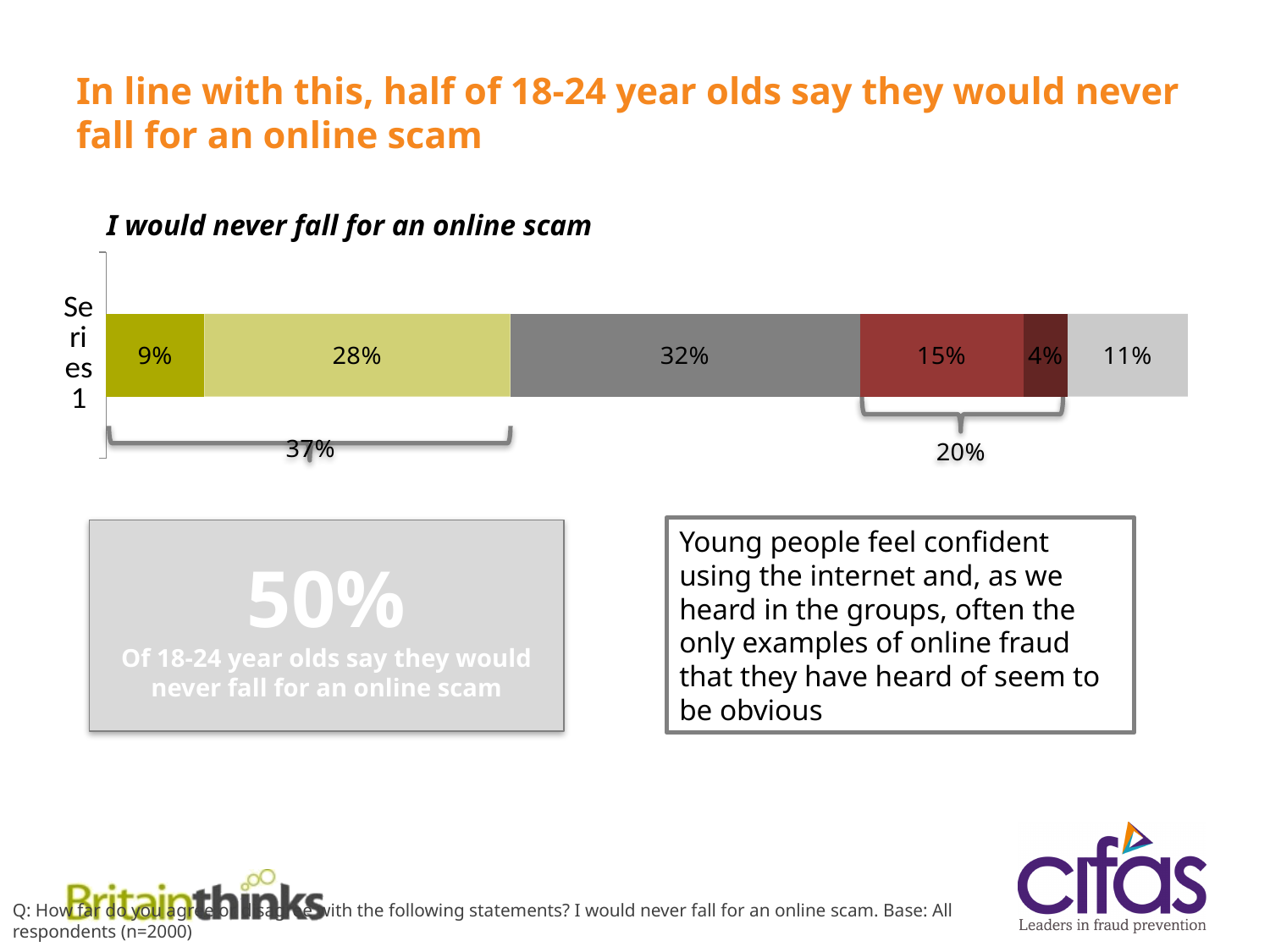
What is the value of the rightmost (light grey) segment of the bar? 11% What is the value of the second (light yellow-green) segment of the bar? 28% What is the value of the leftmost (dark olive) segment of the bar? 9% What value is shown by the bracket under the two red segments? 20% Which segment of the bar has the smallest value? the dark red segment, 4% What is the title of the chart? I would never fall for an online scam Which segment of the bar has the largest value? the grey segment, 32% What kind of chart is shown on the slide? bar chart Which is larger, the second segment (28%) or the red segment (15%)? the second segment, 28% What is the difference between the grey segment (32%) and the light yellow-green segment (28%)? 4 percentage points What value is shown by the bracket under the two leftmost segments? 37% How many segments make up the stacked bar? 6